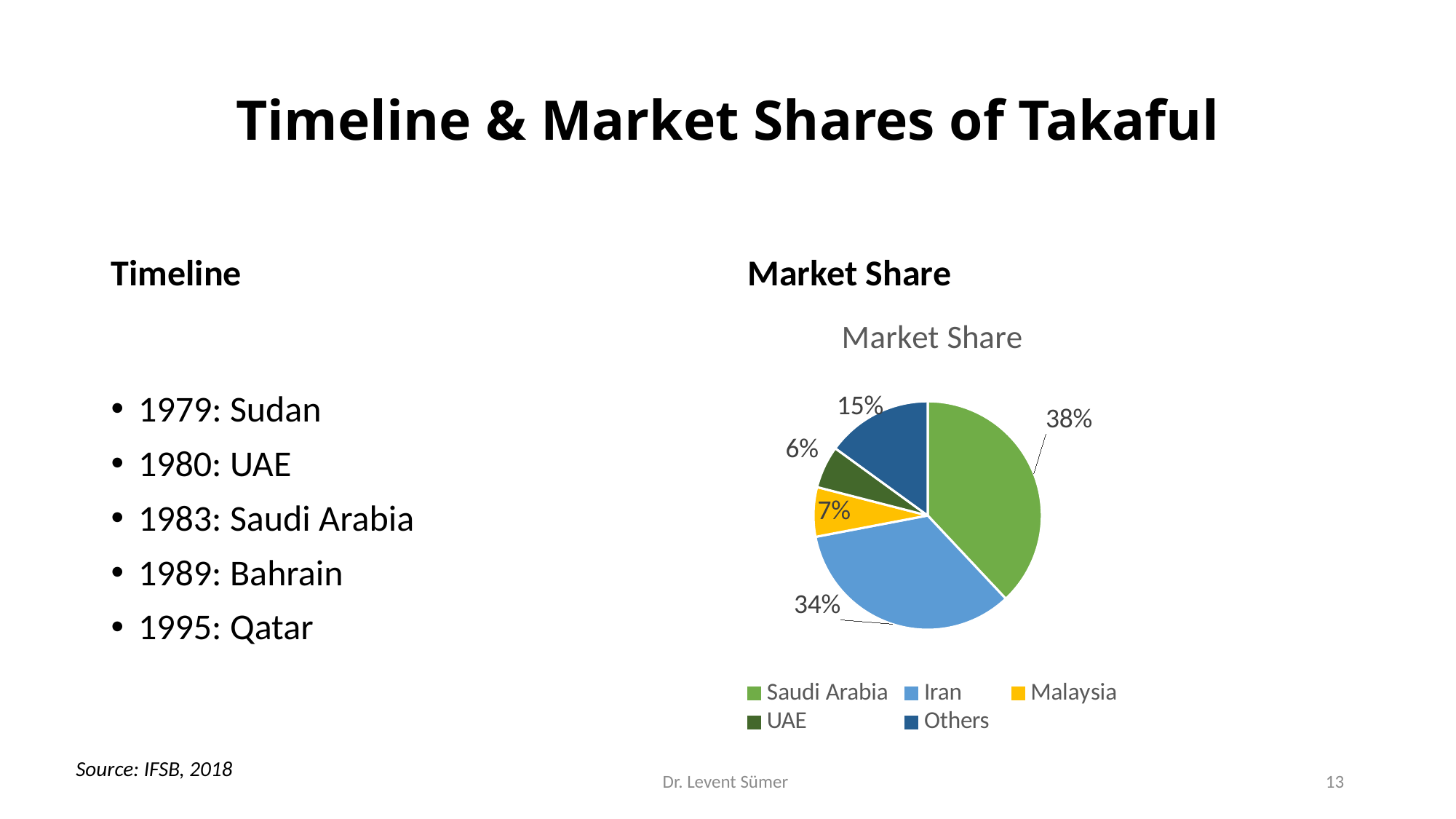
What is the market share of Saudi Arabia? 38% What is the title of the chart? Market Share What is the difference between the shares of Saudi Arabia and Iran? 4% Which category has the largest share of the pie? Saudi Arabia Which has a larger share, Others or Malaysia? Others What is the market share of Others? 15% What is the market share of Iran? 34% Which category has the smallest share of the pie? UAE What is the market share of UAE? 6% What is the market share of Malaysia? 7% How many categories does the legend list? 5 What type of chart is shown on the slide? pie chart